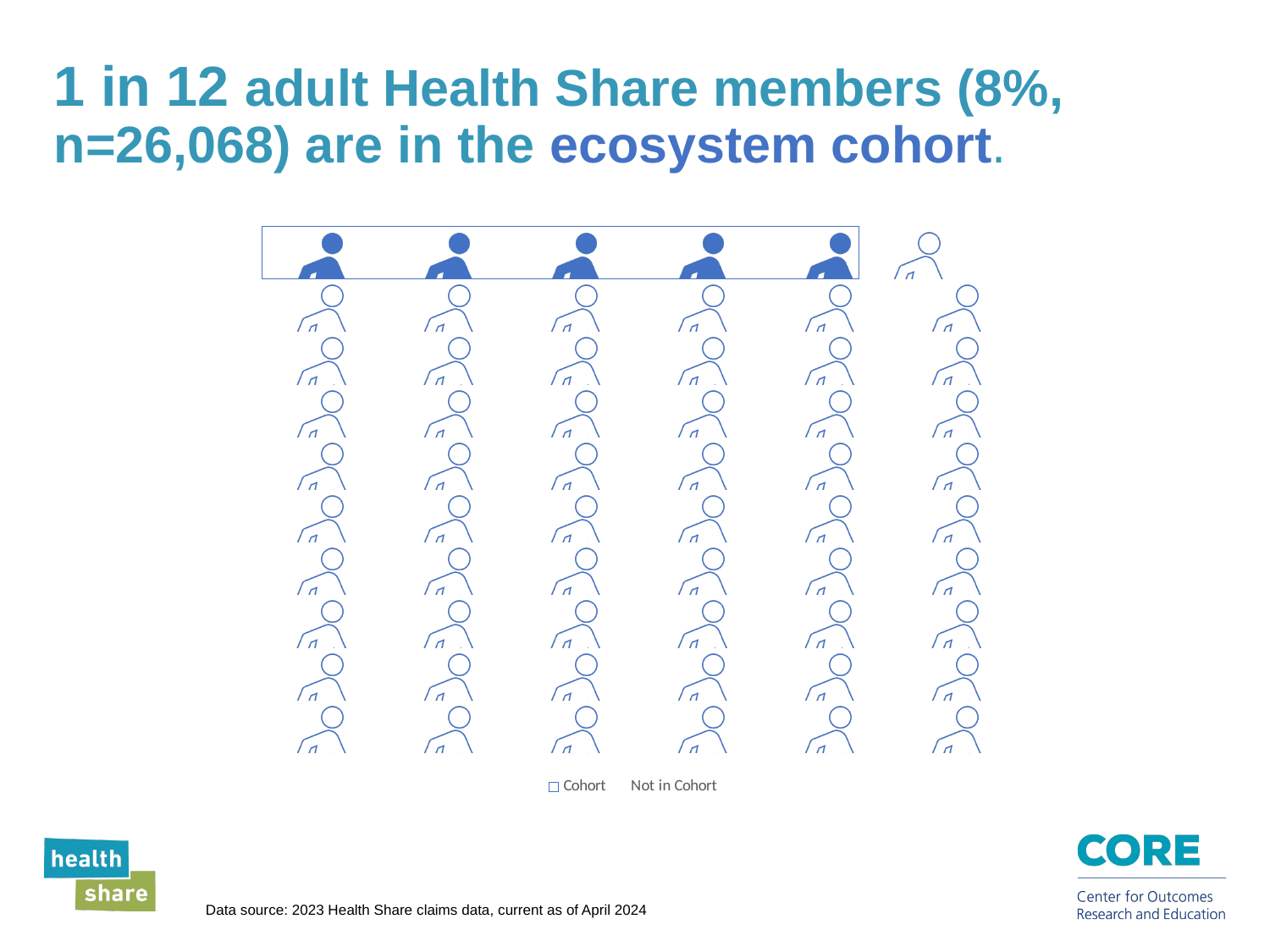
How many columns of icons does the chart have? 6 What are the two legend entries? Cohort; Not in Cohort How many person icons are shown in total? 60 According to the title, how many adult Health Share members are in the ecosystem cohort (n)? 26,068 Which group has more icons, Cohort or Not in Cohort? Not in Cohort According to the title, what percentage of adult Health Share members are in the ecosystem cohort? 8% How many solid (filled) person icons represent the Cohort? 5 According to the title, what ratio of adult Health Share members are in the ecosystem cohort? 1 in 12 How many series does the legend list? 2 What kind of chart is shown on the slide? Pictogram (icon chart) What is the data source stated on the slide? 2023 Health Share claims data, current as of April 2024